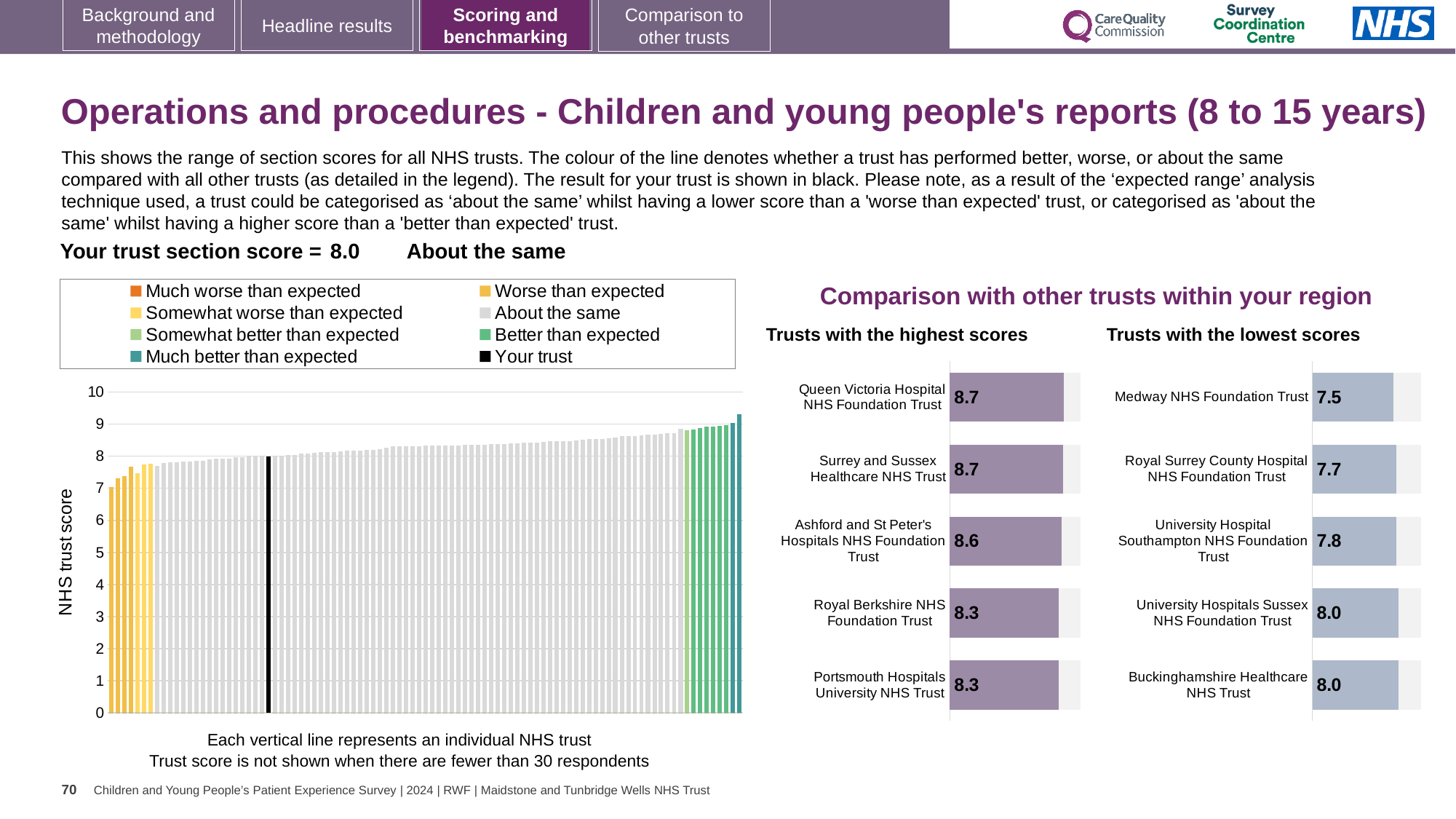
In the NHS trust score chart on the left, is the value of the tallest bar greater or less than 9? greater How many entries does the legend of the NHS trust score chart on the left list? 8 In the 'Trusts with the highest scores' chart, which has the larger score: Ashford and St Peter's Hospitals NHS Foundation Trust or Royal Berkshire NHS Foundation Trust? Ashford and St Peter's Hospitals NHS Foundation Trust What kind of chart is the NHS trust score chart on the left? bar chart In the NHS trust score chart on the left, what is the score of the black bar representing your trust? 8.0 In the NHS trust score chart on the left, do the bar values rise or fall from left to right? rise In the 'Trusts with the lowest scores' chart, what is the difference between the scores of Buckinghamshire Healthcare NHS Trust and Medway NHS Foundation Trust? 0.5 In the 'Trusts with the highest scores' chart, what is the score for Ashford and St Peter's Hospitals NHS Foundation Trust? 8.6 How many trusts are shown in the 'Trusts with the lowest scores' chart? 5 In the 'Trusts with the highest scores' chart, what is the difference between the scores of Queen Victoria Hospital NHS Foundation Trust and Portsmouth Hospitals University NHS Trust? 0.4 In the 'Trusts with the lowest scores' chart, which trust has the lowest score? Medway NHS Foundation Trust In the 'Trusts with the lowest scores' chart, what is the score for Royal Surrey County Hospital NHS Foundation Trust? 7.7